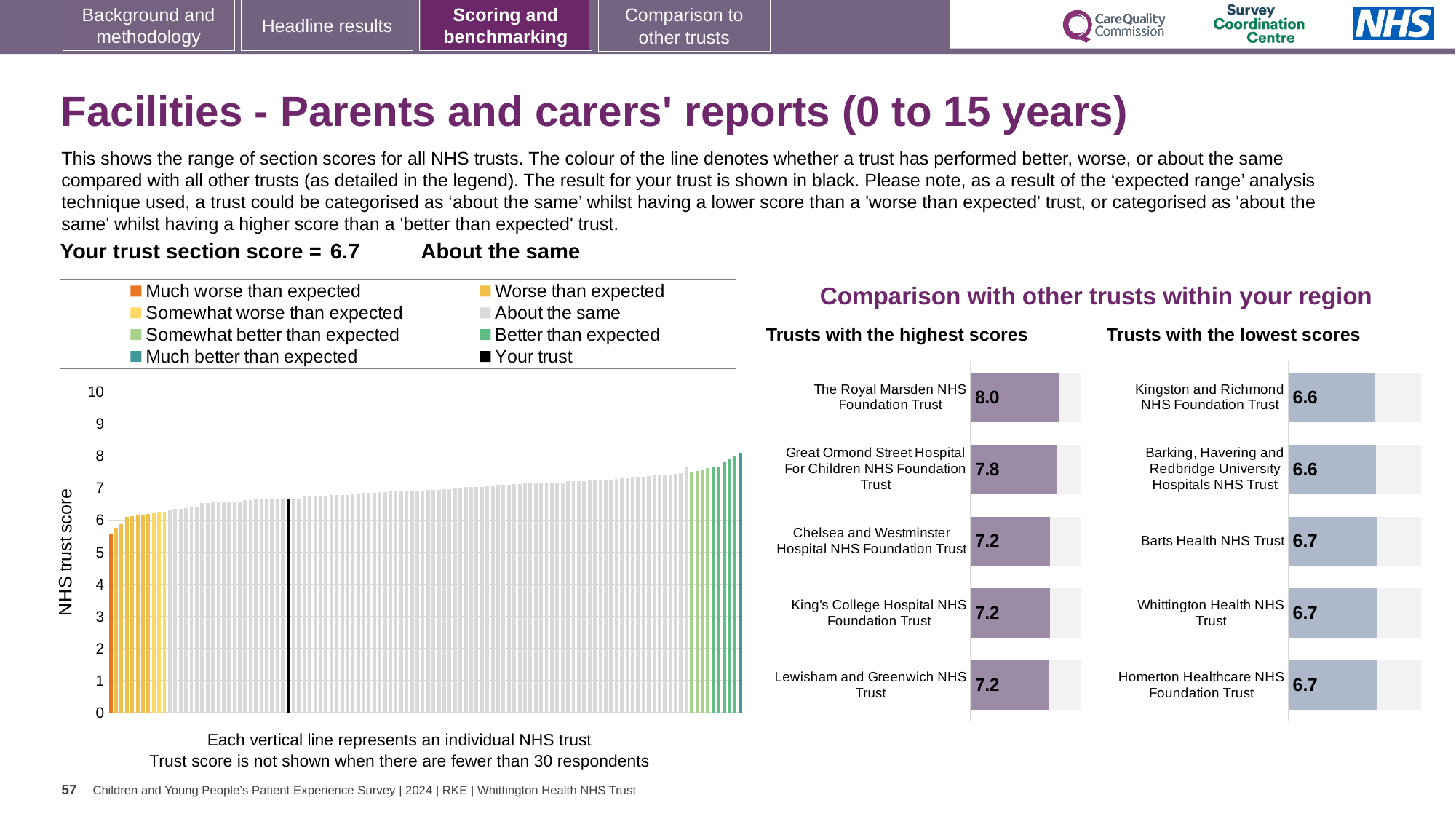
In the 'Trusts with the highest scores' chart, what is the difference between the scores of The Royal Marsden NHS Foundation Trust and Great Ormond Street Hospital For Children NHS Foundation Trust? 0.2 In the 'Trusts with the lowest scores' chart, what is the score for Kingston and Richmond NHS Foundation Trust? 6.6 In the 'Trusts with the highest scores' chart, how many trusts are shown? 5 What kind of chart is the large chart on the left showing all NHS trusts? Bar chart In the 'Trusts with the highest scores' chart, what is the score for Great Ormond Street Hospital For Children NHS Foundation Trust? 7.8 In the 'Trusts with the highest scores' chart, which is larger: the score for The Royal Marsden NHS Foundation Trust or the score for Chelsea and Westminster Hospital NHS Foundation Trust? The Royal Marsden NHS Foundation Trust In the 'Trusts with the lowest scores' chart, what is the difference between the scores of Barts Health NHS Trust and Kingston and Richmond NHS Foundation Trust? 0.1 How many entries does the legend above the large chart on the left list? 8 In the 'Trusts with the highest scores' chart, what is the score for The Royal Marsden NHS Foundation Trust? 8.0 In the 'Trusts with the lowest scores' chart, what is the score for Whittington Health NHS Trust? 6.7 In the large chart on the left, do the trust scores rise or fall from left to right? Rise In the 'Trusts with the highest scores' chart, which trust has the highest score? The Royal Marsden NHS Foundation Trust